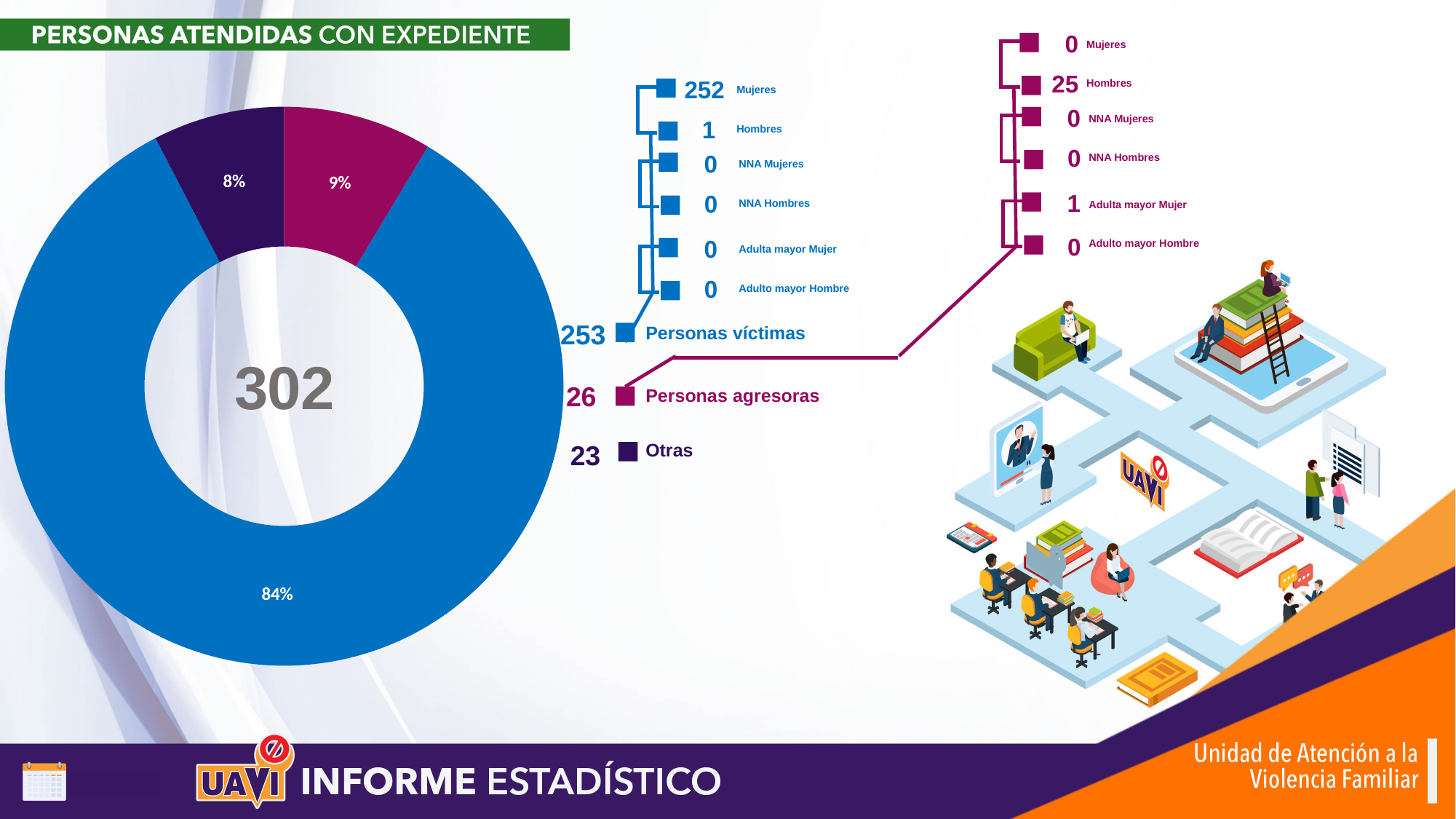
What is the total number shown in the center of the donut chart? 302 How many people are listed as Personas agresoras? 26 What is the difference between the number of Personas víctimas and Personas agresoras? 227 Which category has the smallest slice of the donut chart? Otras How many categories does the donut chart legend list? 3 Which category has the largest slice of the donut chart? Personas víctimas How many people are listed as Personas víctimas? 253 How many people are listed as Otras? 23 What kind of chart is shown on the slide? Donut (pie) chart What percentage of the donut chart corresponds to Personas víctimas? 84% What percentage of the donut chart corresponds to Personas agresoras? 9% What percentage of the donut chart corresponds to Otras? 8%